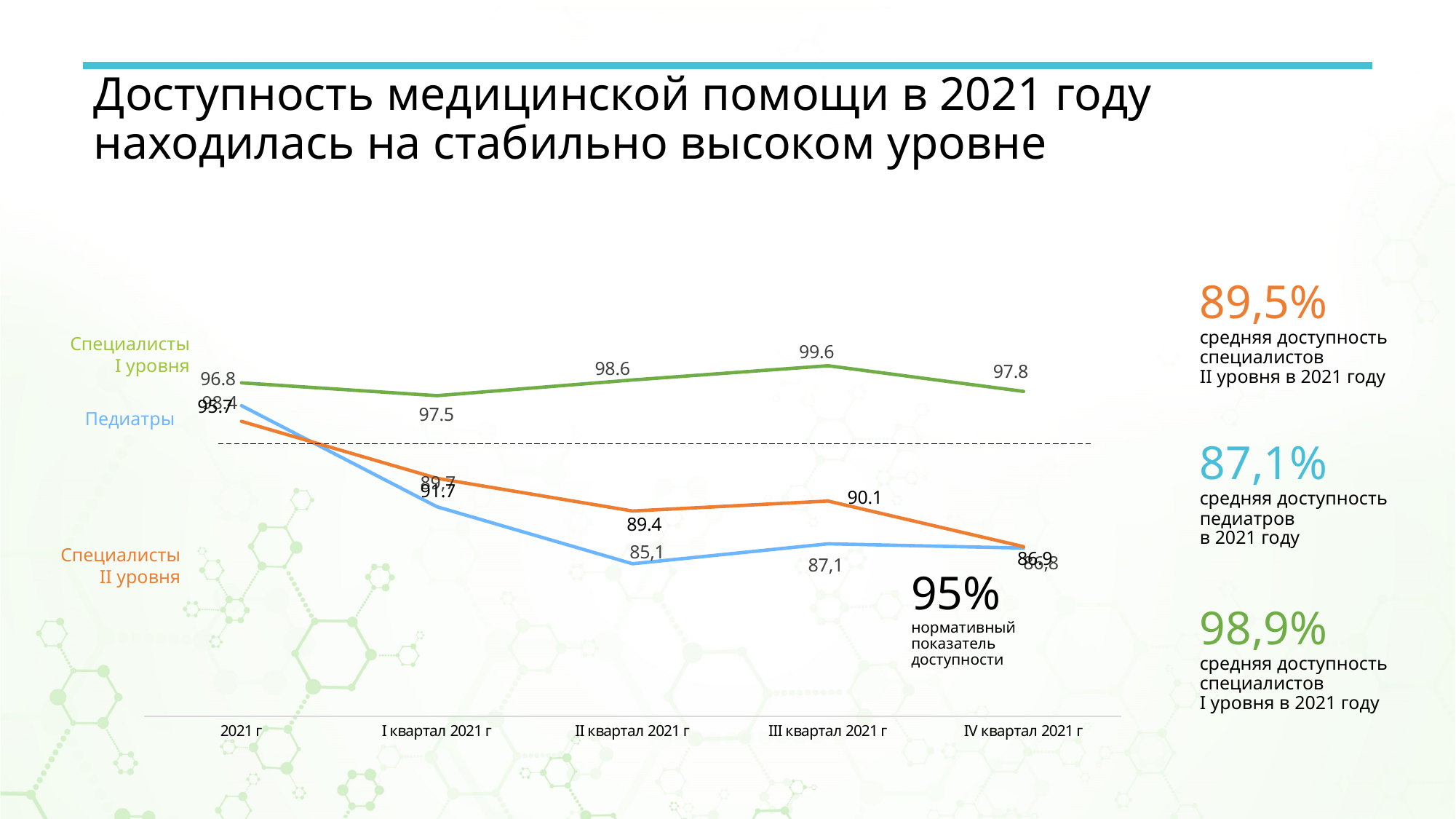
In which period is the value for Педиатры lowest? II квартал 2021 г What kind of chart is shown on the slide? line chart What is the value for Специалисты I уровня in I квартал 2021 г? 97.5 What is the value for Педиатры in II квартал 2021 г? 85,1 Which series has the larger value in III квартал 2021 г, Специалисты I уровня or Специалисты II уровня? Специалисты I уровня How many points along the x axis does the chart have? 5 In which period is the value for Специалисты I уровня highest? III квартал 2021 г How many series are plotted on the chart? 3 What is the difference between the Специалисты I уровня values in III квартал 2021 г and I квартал 2021 г? 2.1 What is the value for Педиатры in IV квартал 2021 г? 86,8 What is the value for Специалисты II уровня in III квартал 2021 г? 90.1 What is the value for Специалисты I уровня in III квартал 2021 г? 99.6